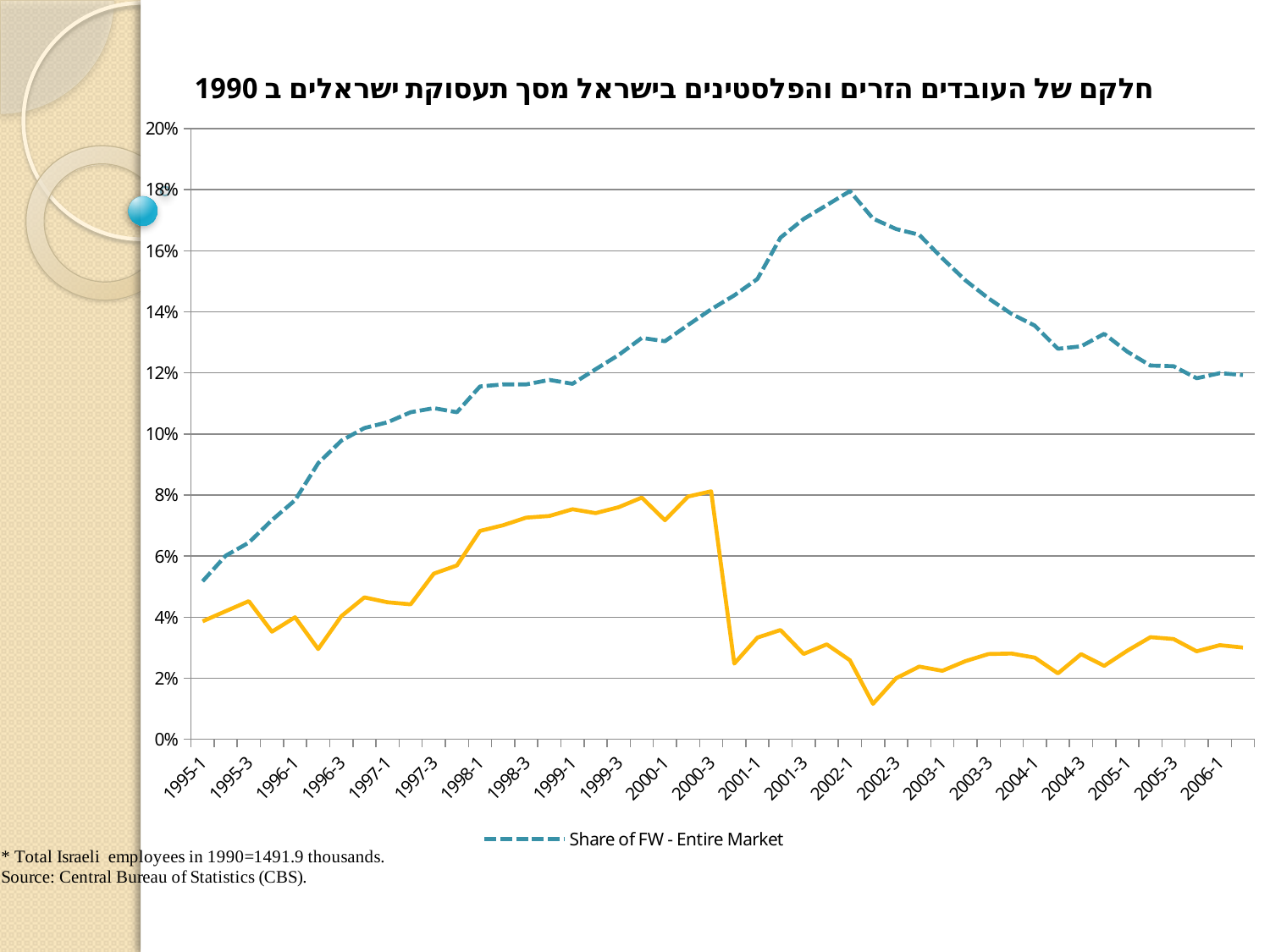
What kind of chart is shown on the slide? line chart What is the name of the series listed in the legend? Share of FW - Entire Market Is the value of the dashed 'Share of FW - Entire Market' line at 1995-1 greater or less than 6%? less Is the value of the dashed 'Share of FW - Entire Market' line at 2006-1 greater or less than 14%? less Does the dashed 'Share of FW - Entire Market' line rise or fall between 1995-1 and 2002-1? rise At 2002-1, which line is higher: the dashed 'Share of FW - Entire Market' line or the solid orange line? the dashed 'Share of FW - Entire Market' line Is the value of the solid orange line at 2003-1 greater or less than 4%? less What is the highest value shown on the vertical axis? 20% How many series does the legend list? 1 Does the dashed 'Share of FW - Entire Market' line rise or fall between 2002-1 and 2006-1? fall